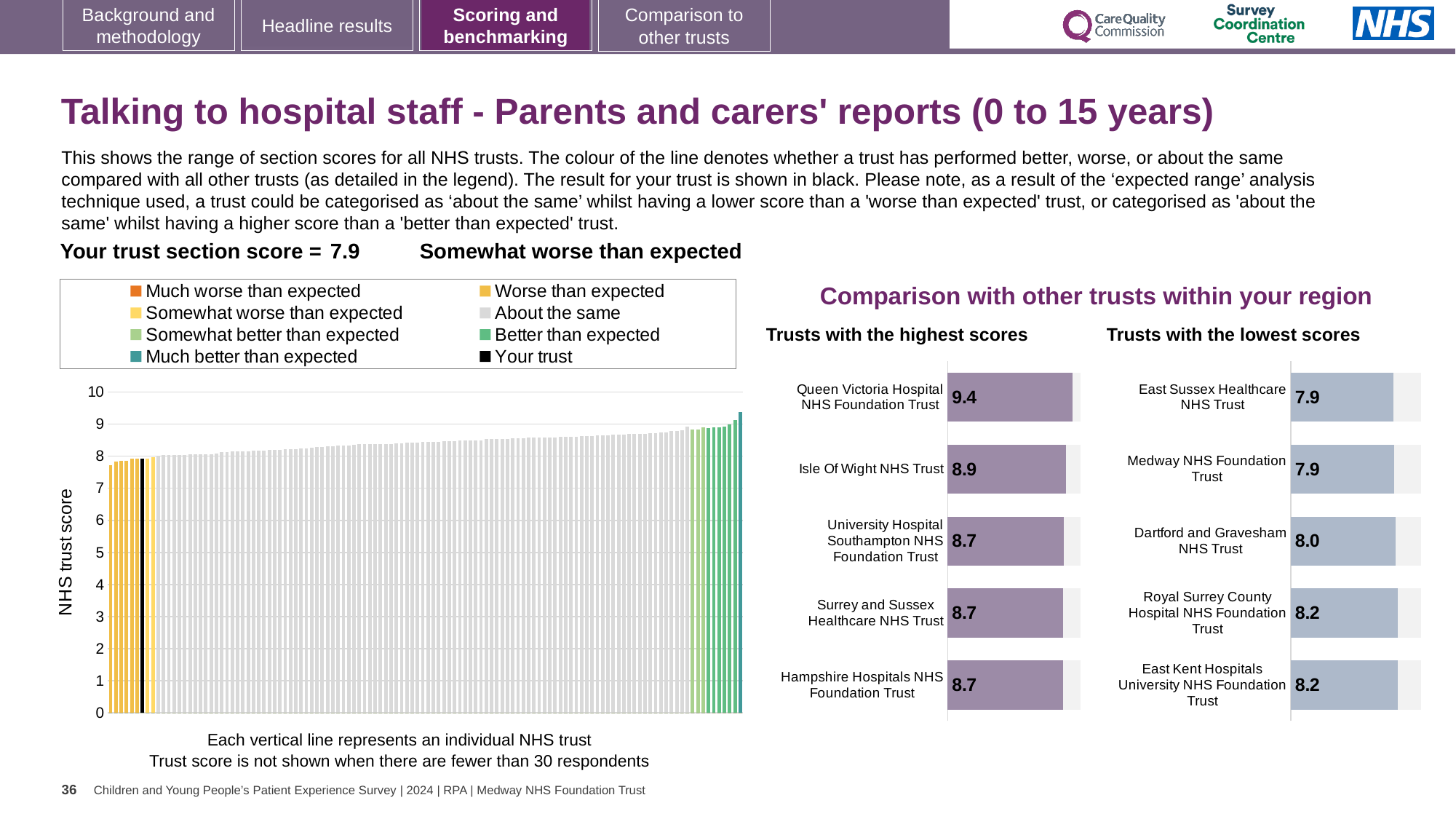
How many trusts are shown in the 'Trusts with the highest scores' chart? 5 In the 'NHS trust score' chart on the left, is the value of the tallest bar greater or less than 9? greater What type of chart is the 'NHS trust score' chart on the left of the slide? Bar chart In the 'Trusts with the highest scores' chart, what is the score for Queen Victoria Hospital NHS Foundation Trust? 9.4 In the 'Trusts with the highest scores' chart, what is the difference between the scores of Queen Victoria Hospital NHS Foundation Trust and Isle Of Wight NHS Trust? 0.5 In the 'Trusts with the lowest scores' chart, what is the score for Dartford and Gravesham NHS Trust? 8.0 In the 'Trusts with the highest scores' chart, which trust has the highest score? Queen Victoria Hospital NHS Foundation Trust In the 'Trusts with the highest scores' chart, what is the score for Isle Of Wight NHS Trust? 8.9 In the 'Trusts with the lowest scores' chart, what is the score for Royal Surrey County Hospital NHS Foundation Trust? 8.2 In the 'Trusts with the lowest scores' chart, which is larger: the score for Dartford and Gravesham NHS Trust or the score for East Sussex Healthcare NHS Trust? Dartford and Gravesham NHS Trust In the 'Trusts with the lowest scores' chart, what is the difference between the scores of East Kent Hospitals University NHS Foundation Trust and Medway NHS Foundation Trust? 0.3 How many entries does the legend of the 'NHS trust score' chart on the left list? 8